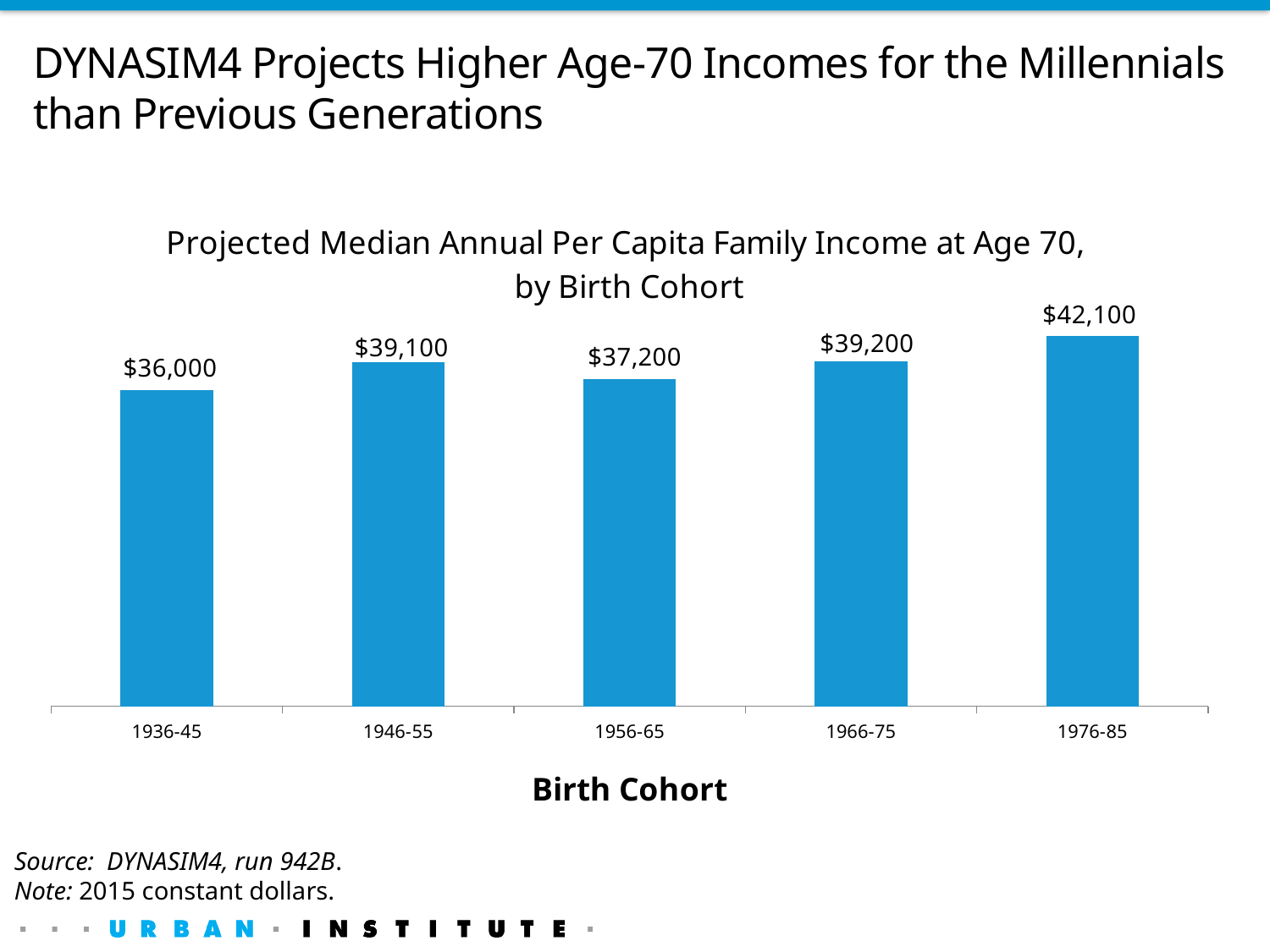
Which birth cohort has the highest projected median income at age 70? 1976-85 What is the projected median annual per capita family income at age 70 for the 1956-65 birth cohort? $37,200 Which cohort has a higher projected income at age 70, 1946-55 or 1956-65? 1946-55 What kind of chart is shown on the slide? Bar chart What is the title of the chart? Projected Median Annual Per Capita Family Income at Age 70, by Birth Cohort What is the difference between the projected income for the 1946-55 cohort and the 1956-65 cohort? $1,900 Which birth cohort has the lowest projected median income at age 70? 1936-45 How many birth cohorts are shown in the chart? 5 What is the projected median annual per capita family income at age 70 for the 1976-85 birth cohort? $42,100 What is the difference between the projected income for the 1976-85 cohort and the 1936-45 cohort? $6,100 What is the projected median annual per capita family income at age 70 for the 1936-45 birth cohort? $36,000 What is the label of the x axis? Birth Cohort